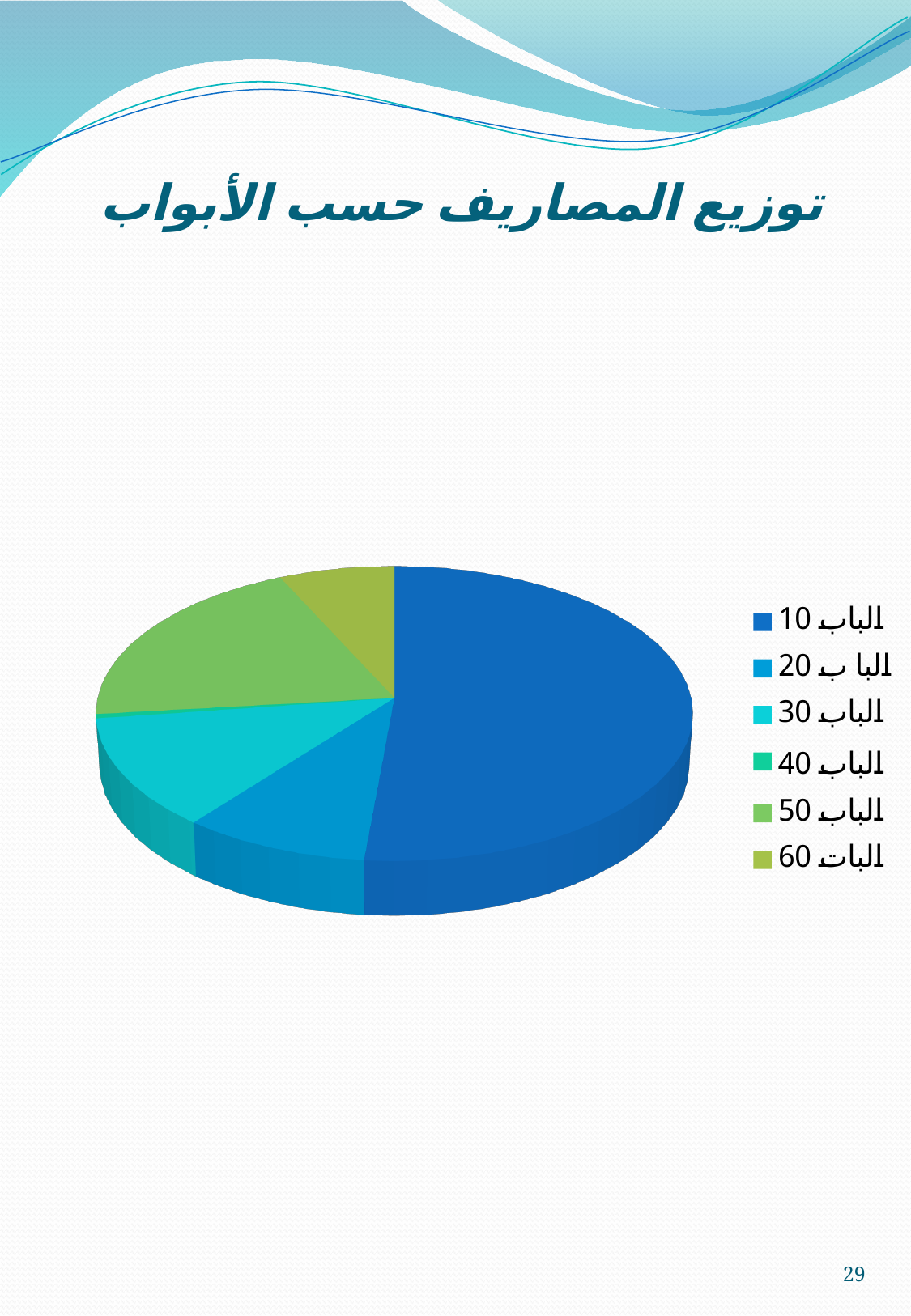
Which category has the largest slice of the pie? الباب 10 Which slice is larger, الباب 10 or الباب 20? الباب 10 How many entries does the chart's legend list? 6 What colour is the slice for الباب 10 in the legend? dark blue Which slice is larger, الباب 50 or البات 60? الباب 50 What kind of chart is shown on the slide? pie chart Which slice is larger, الباب 10 or الباب 50? الباب 10 What is the title of the chart on the slide? توزيع المصاريف حسب الأبواب